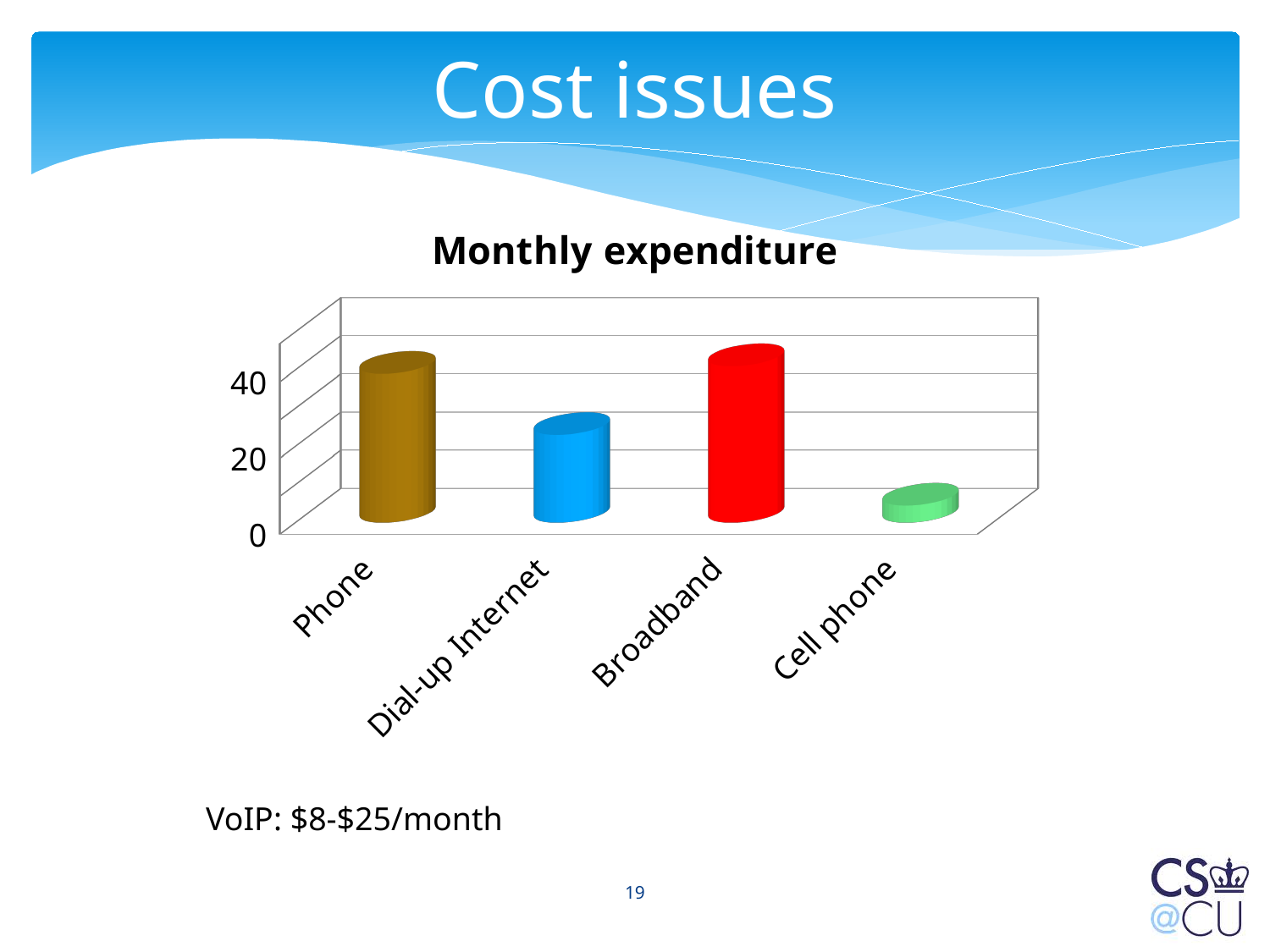
What colour is the bar for Broadband? red What is the title of the chart? Monthly expenditure Is the value for Broadband greater or less than 20? greater Is the value for Cell phone greater or less than 20? less Is the value for Dial-up Internet greater or less than 40? less Which category has the highest monthly expenditure? Broadband What kind of chart is shown on the slide? bar chart How many categories are shown on the x axis of the chart? 4 Which category has the lowest monthly expenditure? Cell phone Which is larger, the value for Phone or the value for Dial-up Internet? Phone Which is larger, the value for Dial-up Internet or the value for Cell phone? Dial-up Internet